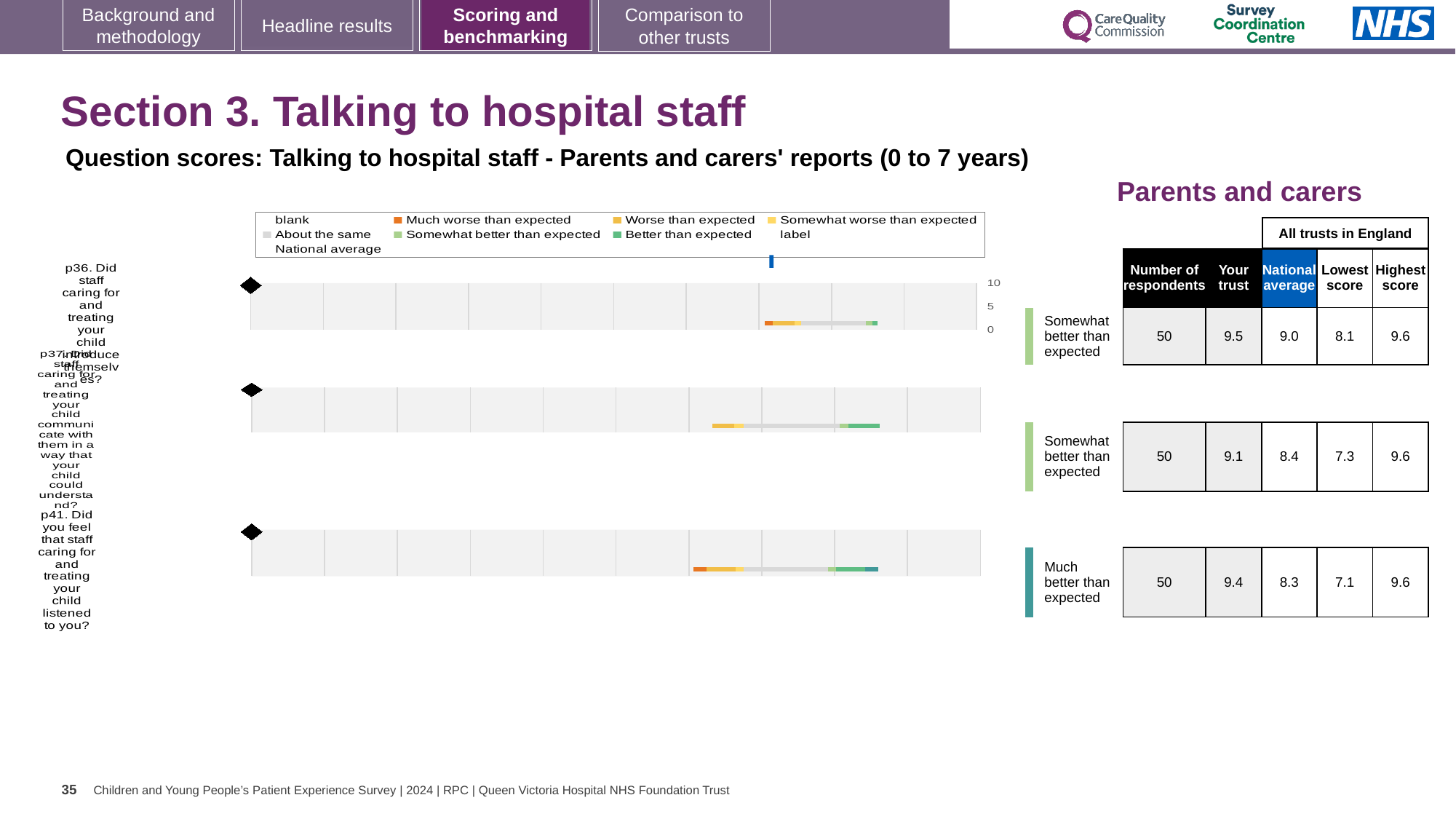
What is the difference between the trust score and the national average for p41? 1.1 Is the trust score for p36 greater or less than 5 on the chart's axis? greater What is the lowest score across all trusts in England for p41 (Did you feel that staff listened to you)? 7.1 What benchmark category is shown for p41? Much better than expected How many survey questions are plotted as rows in the chart? 3 What is the 'Your trust' score for p36 (Did staff caring for and treating your child introduce themselves)? 9.5 What is the national average score for p37 (Did staff communicate with your child in a way they could understand)? 8.4 What is the highest score across all trusts in England for p37? 9.6 How many respondents answered p36? 50 Which has the larger 'Your trust' score, p37 or p41? p41 Which question has the lowest national average score? p41 Which question has the highest 'Your trust' score? p36